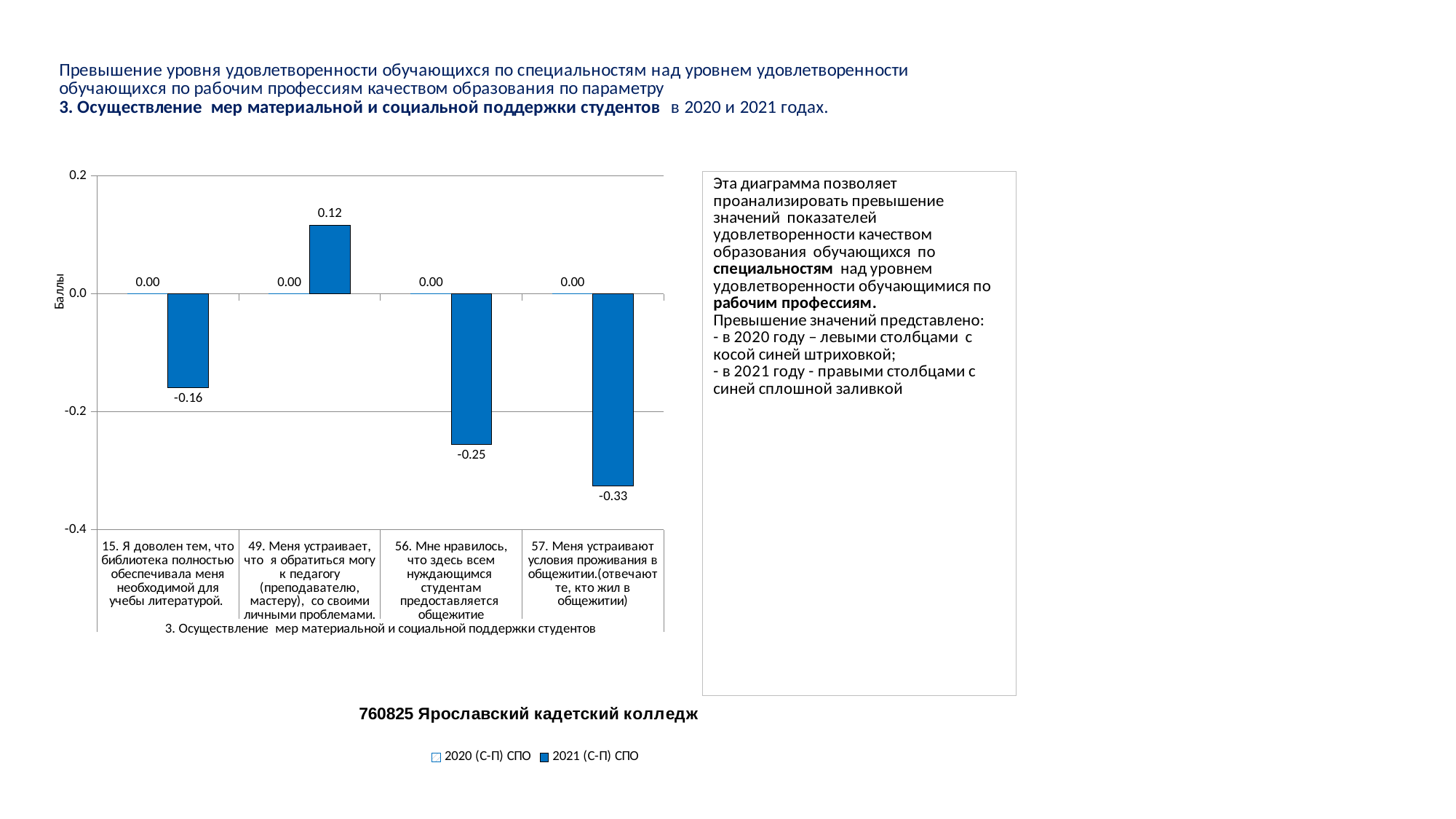
What is the 2021 (С-П) СПО value for category 57 (satisfied with dormitory living conditions)? -0.33 What is the 2021 (С-П) СПО value for category 15 (library provided necessary literature)? -0.16 What is the 2021 (С-П) СПО value for category 56 (dormitory provided to all students in need)? -0.25 What type of chart is shown on the slide? Bar chart Which category has the lowest 2021 (С-П) СПО value? 57. Меня устраивают условия проживания в общежитии What is the 2021 (С-П) СПО value for category 49 (can approach a teacher with personal problems)? 0.12 How many series does the legend list? 2 Which is larger: the 2021 value for category 15 or for category 56? Category 15 (-0.16) How many categories are shown on the x axis? 4 What is the 2020 (С-П) СПО value for category 15? 0.00 What is the difference between the 2021 values for category 49 and category 57? 0.45 Which category has the highest 2021 (С-П) СПО value? 49. Меня устраивает, что я обратиться могу к педагогу